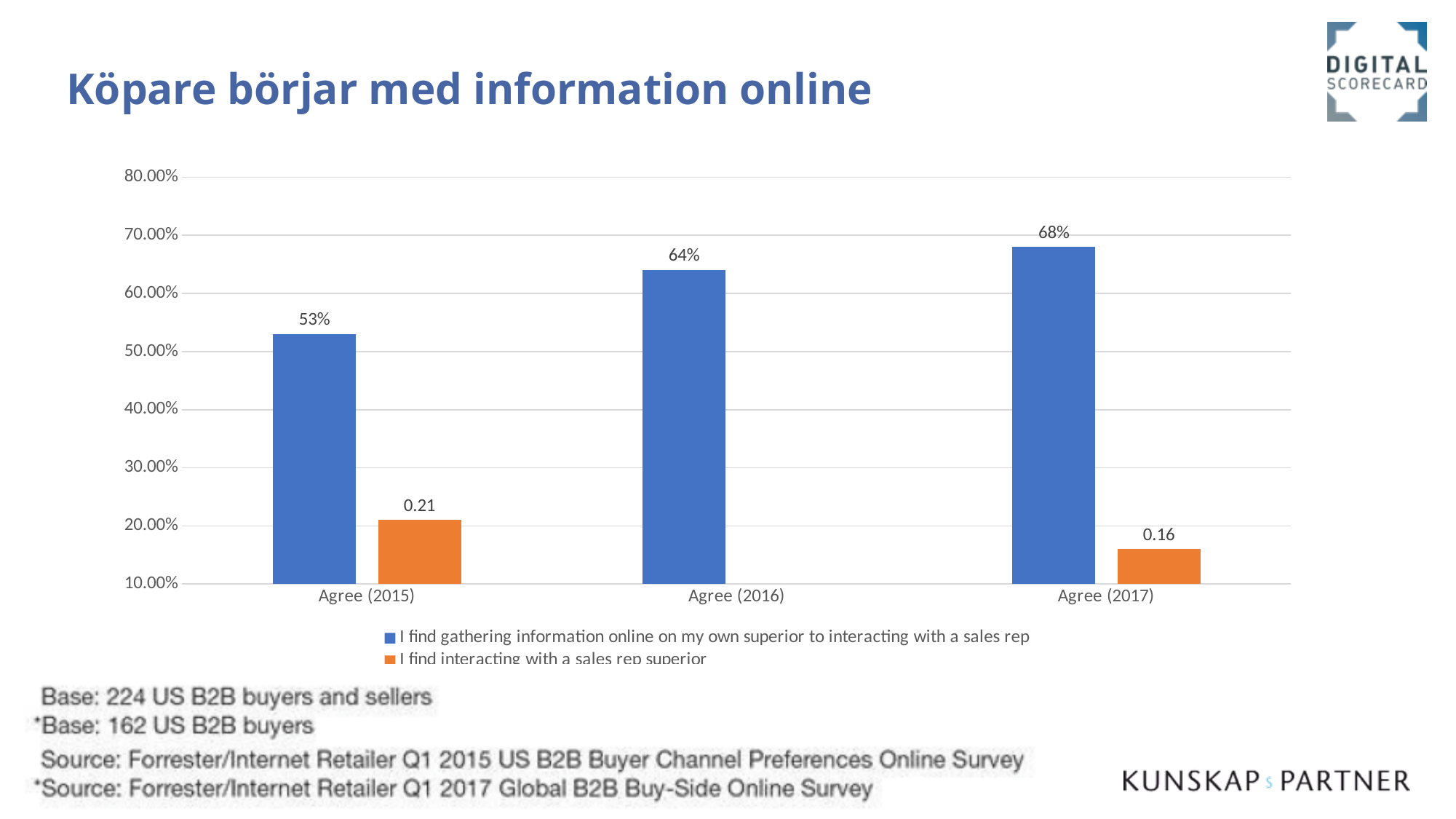
What is the value for 'I find gathering information online on my own superior to interacting with a sales rep' in Agree (2016)? 64% What data label is shown for 'I find interacting with a sales rep superior' in Agree (2015)? 0.21 What is the difference in percentage points between the blue bars for Agree (2017) and Agree (2015)? 15 In which category is the blue series 'I find gathering information online on my own superior to interacting with a sales rep' lowest? Agree (2015) Does the blue series rise or fall from Agree (2015) to Agree (2017)? rise Is the blue bar for Agree (2015) greater or less than 50.00%? greater What is the value for 'I find gathering information online on my own superior to interacting with a sales rep' in Agree (2017)? 68% In which category is the blue series 'I find gathering information online on my own superior to interacting with a sales rep' highest? Agree (2017) How many series does the legend list? 2 Which is larger: the blue bar for Agree (2015) or the blue bar for Agree (2016)? Agree (2016) What data label is shown for 'I find interacting with a sales rep superior' in Agree (2017)? 0.16 How many categories are shown on the x axis? 3